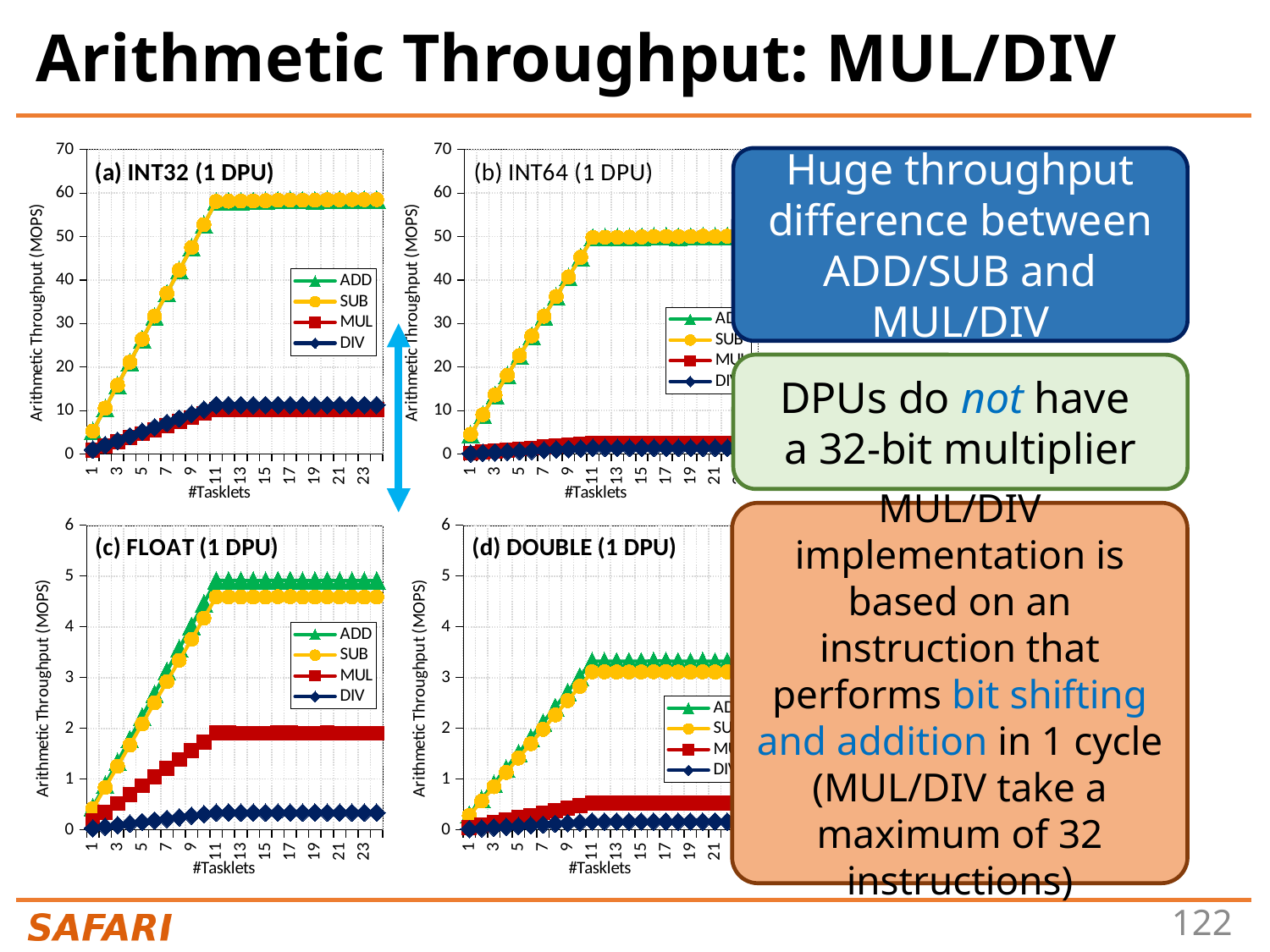
In chart (a) INT32 (1 DPU), is the value for MUL at 23 tasklets greater or less than 20? less What kind of chart is chart (a) INT32 (1 DPU)? line chart What are the legend entries in chart (c) FLOAT (1 DPU)? ADD, SUB, MUL, DIV In chart (b) INT64 (1 DPU), is the value for SUB at 15 tasklets greater or less than 40? greater In chart (c) FLOAT (1 DPU), is the value for MUL at 23 tasklets greater or less than 3? less What is the y-axis label of chart (a) INT32 (1 DPU)? Arithmetic Throughput (MOPS) In chart (c) FLOAT (1 DPU), which series has the lowest throughput at 23 tasklets? DIV In chart (a) INT32 (1 DPU), at 23 tasklets, which is larger, ADD or MUL? ADD How many series does the legend of chart (a) INT32 (1 DPU) list? 4 In chart (a) INT32 (1 DPU), does the ADD series rise or fall as the number of tasklets goes from 1 to 11? rise